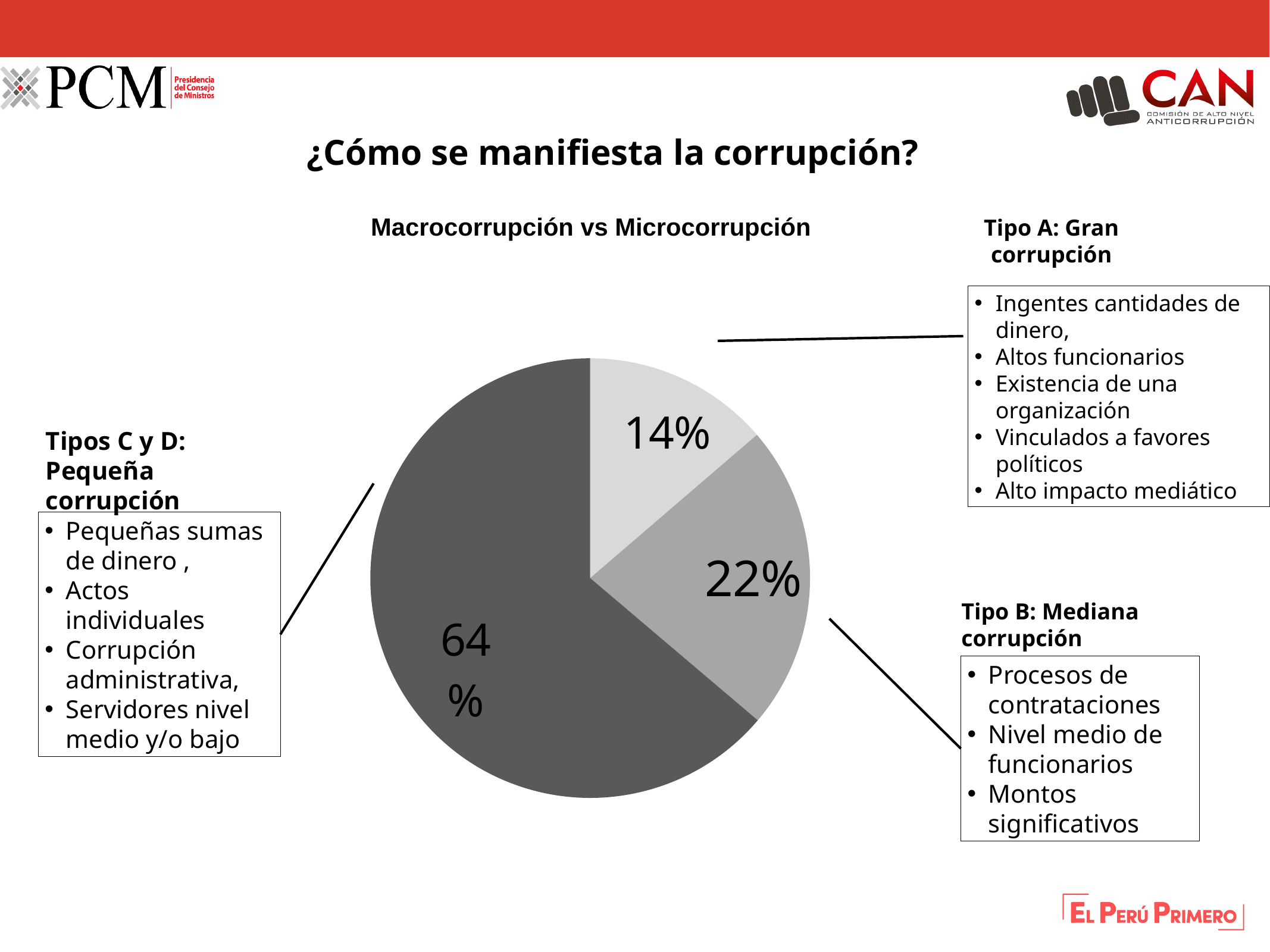
What share of the pie corresponds to Tipo B: Mediana corrupción? 22% What share of the pie corresponds to Tipos C y D: Pequeña corrupción? 64% What kind of chart is shown on the slide? pie chart What colour is the slice representing Tipos C y D: Pequeña corrupción? dark grey What is the title of the chart? Macrocorrupción vs Microcorrupción How many slices does the pie chart have? 3 What share of the pie corresponds to Tipo A: Gran corrupción? 14% What is the difference in percentage points between the Tipo B slice and the Tipo A slice? 8 Which slice is larger, Tipo A: Gran corrupción or Tipo B: Mediana corrupción? Tipo B: Mediana corrupción What is the difference in percentage points between the Tipos C y D slice and the Tipo B slice? 42 Which type of corruption has the smallest slice of the pie? Tipo A: Gran corrupción Which type of corruption has the largest slice of the pie? Tipos C y D: Pequeña corrupción